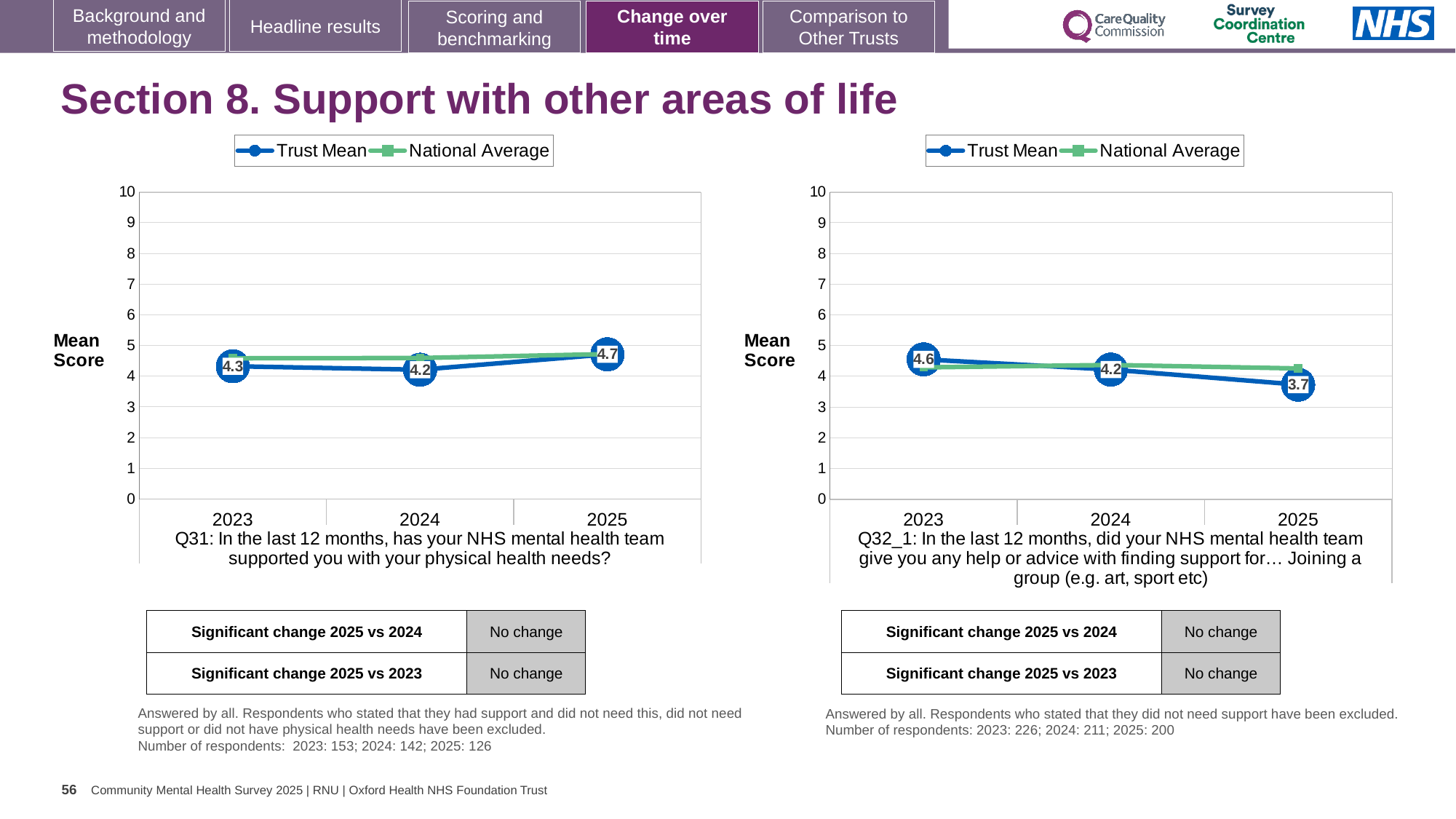
In the left chart (Q31), is the National Average value for 2023 greater or less than 4? greater In the right chart (Q32_1), does the Trust Mean rise or fall from 2023 to 2025? fall In the right chart (Q32_1), what is the Trust Mean score for 2025? 3.7 How many years are plotted on the x axis of the left chart (Q31)? 3 In the left chart (Q31), what is the Trust Mean score for 2025? 4.7 In the right chart (Q32_1), which year has the lowest Trust Mean score? 2025 What kind of chart is the left chart (Q31)? line chart In the left chart (Q31), is the Trust Mean score higher in 2024 or in 2025? 2025 How many series does the legend of the right chart (Q32_1) list? 2 In the right chart (Q32_1), what is the Trust Mean score for 2023? 4.6 In the left chart (Q31), which year has the highest Trust Mean score? 2025 In the right chart (Q32_1), what is the difference between the Trust Mean scores for 2023 and 2025? 0.9